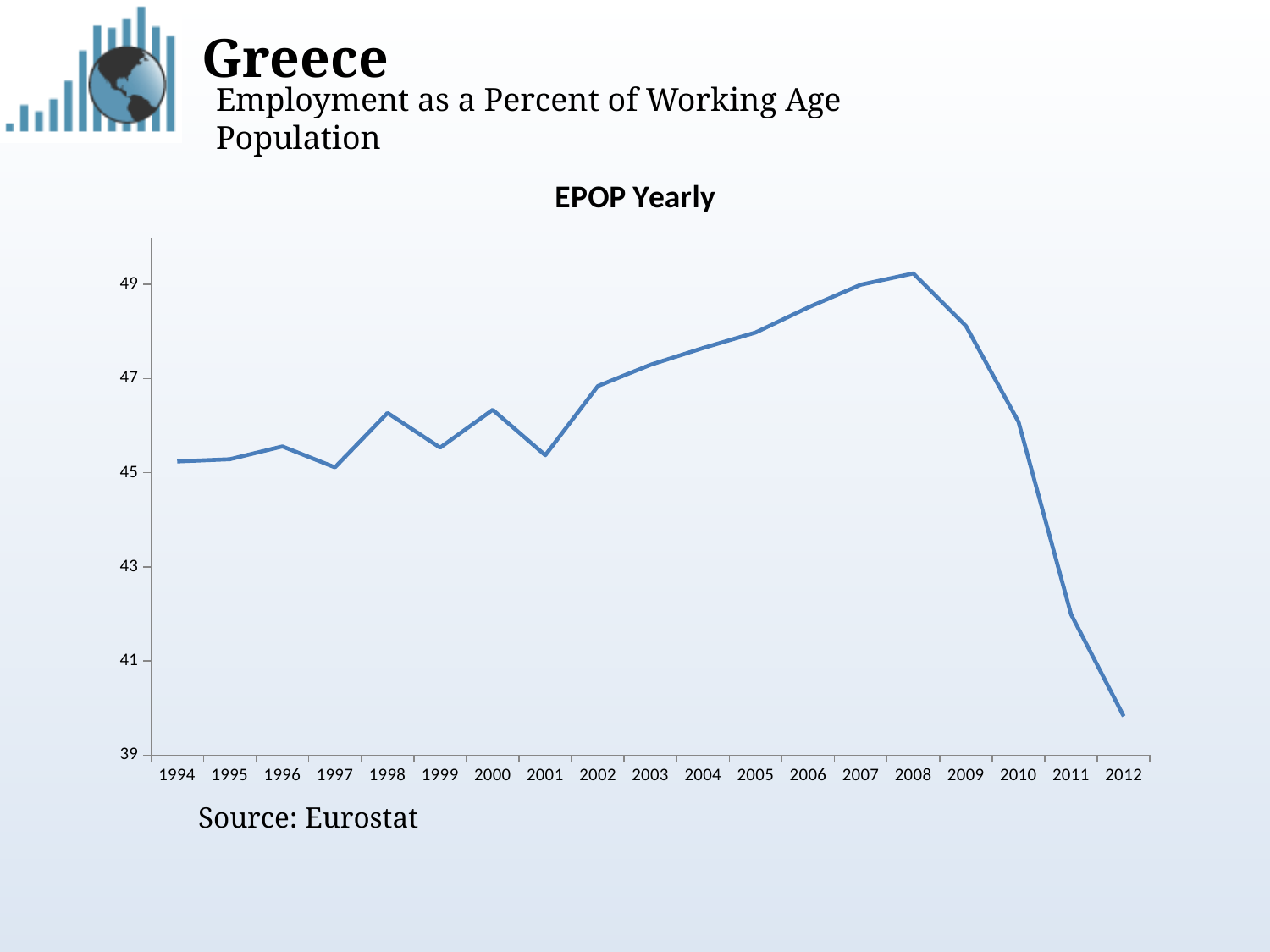
Is the value for 2011 greater or less than 43? less Is the value for 2010 greater or less than 45? greater Which year has the larger EPOP value, 2005 or 2011? 2005 What kind of chart is shown on the slide? line chart How many years are plotted on the x axis of the chart? 19 Do the values rise or fall from 2008 to 2012? fall In which year is the EPOP value highest? 2008 What is the title of the chart? EPOP Yearly In which year is the EPOP value lowest? 2012 Is the value for 2012 greater or less than 41? less What source is cited for the chart data? Eurostat